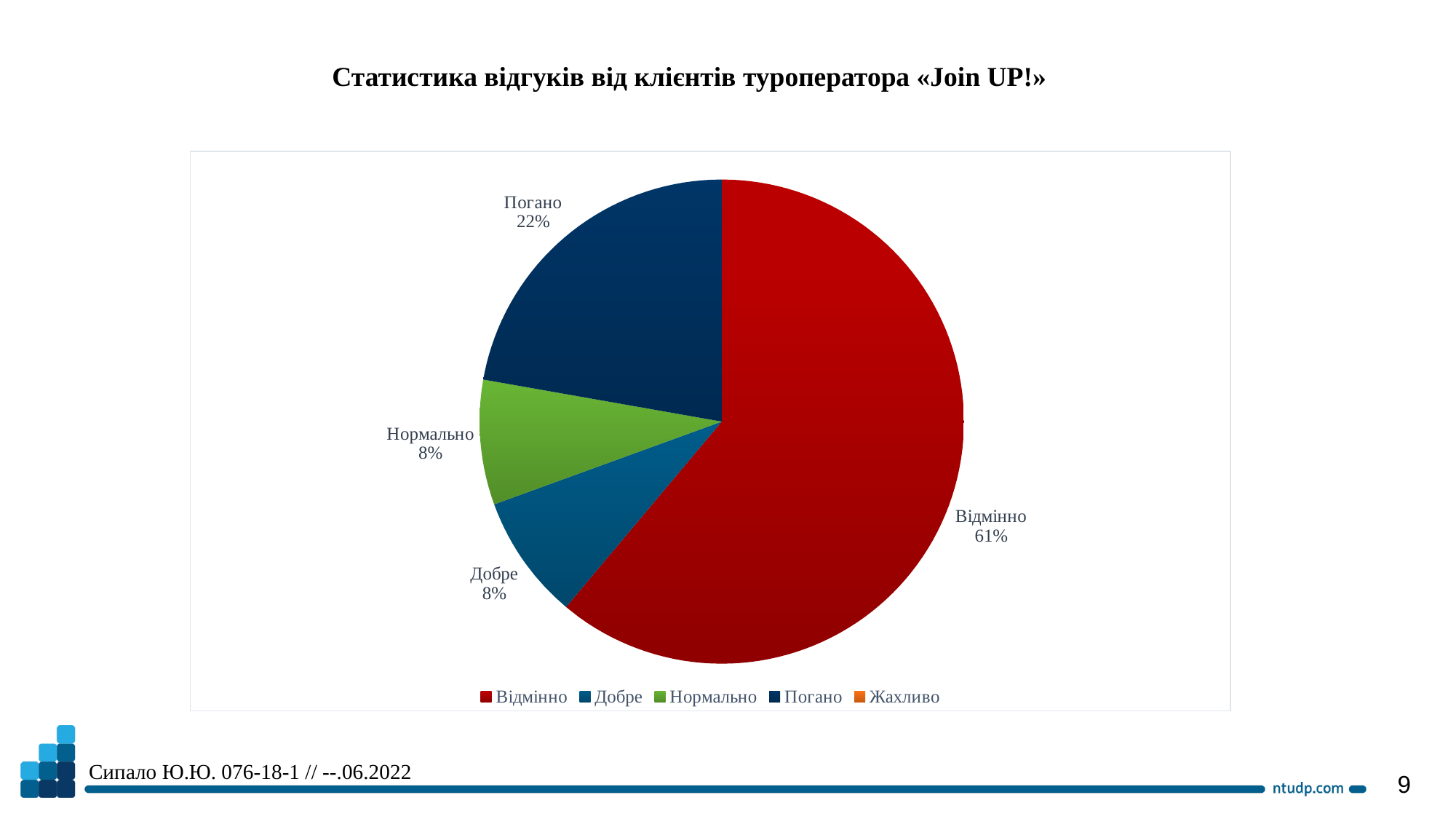
What share of the pie does the Відмінно slice represent? 61% What kind of chart is shown on the slide? pie chart What is the title of the slide? Статистика відгуків від клієнтів туроператора «Join UP!» How many slices of the pie are labelled with a percentage? 4 Which is larger, the slice for Погано or the slice for Добре? Погано What is the difference in percentage points between Відмінно and Погано? 39 What is the value shown for Погано? 22% How many entries does the legend list? 5 What is the value shown for Нормально? 8% Which category has the largest slice of the pie? Відмінно What is the combined share of Відмінно and Погано? 83% What is the value shown for Добре? 8%